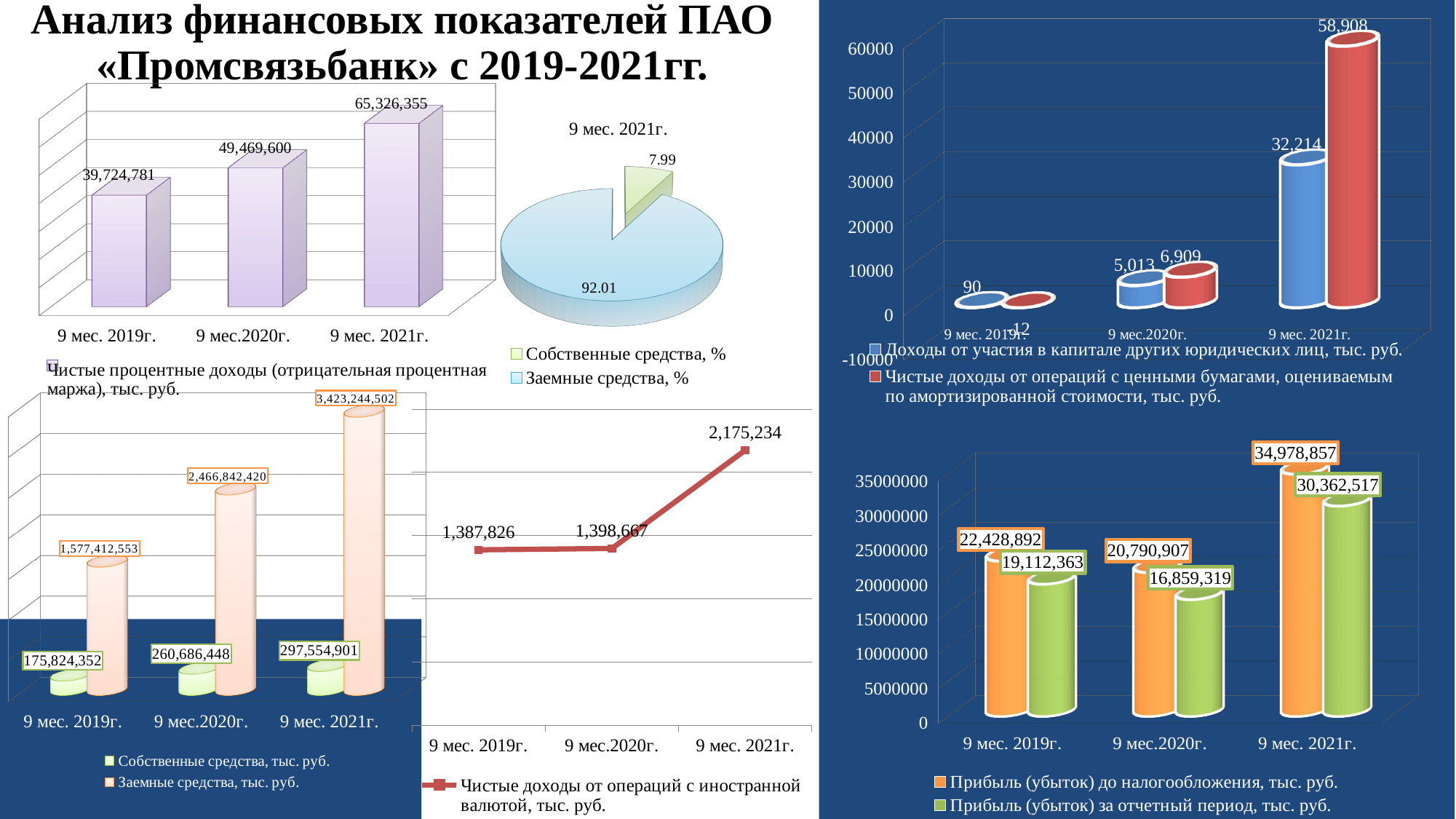
In the top-right bar chart, how many series does the legend list? 2 What type of chart is the chart titled '9 мес. 2021г.' in the top middle of the slide? pie chart In the top-right bar chart, what is the value of Чистые доходы от операций с ценными бумагами for 9 мес. 2021г.? 58,908 In the top-left bar chart (Чистые процентные доходы), what is the value for 9 мес. 2021г.? 65,326,355 In the bottom-left bar chart, which is larger for 9 мес. 2019г.: Собственные средства or Заемные средства? Заемные средства In the top-left bar chart (Чистые процентные доходы), which period has the lowest value? 9 мес. 2019г. In the bottom-right bar chart, what is the difference between Прибыль (убыток) до налогообложения and Прибыль (убыток) за отчетный период for 9 мес. 2021г.? 4,616,340 In the bottom-middle line chart, do the values rise or fall from 9 мес. 2019г. to 9 мес. 2021г.? rise In the pie chart titled '9 мес. 2021г.', what share is Собственные средства, %? 7.99 In the bottom-left bar chart, what is the value of Заемные средства, тыс. руб. for 9 мес.2020г.? 2,466,842,420 In the top-right bar chart, what is the difference between the two series for 9 мес.2020г.? 1,896 In the bottom-middle line chart (Чистые доходы от операций с иностранной валютой), what is the value for 9 мес. 2021г.? 2,175,234